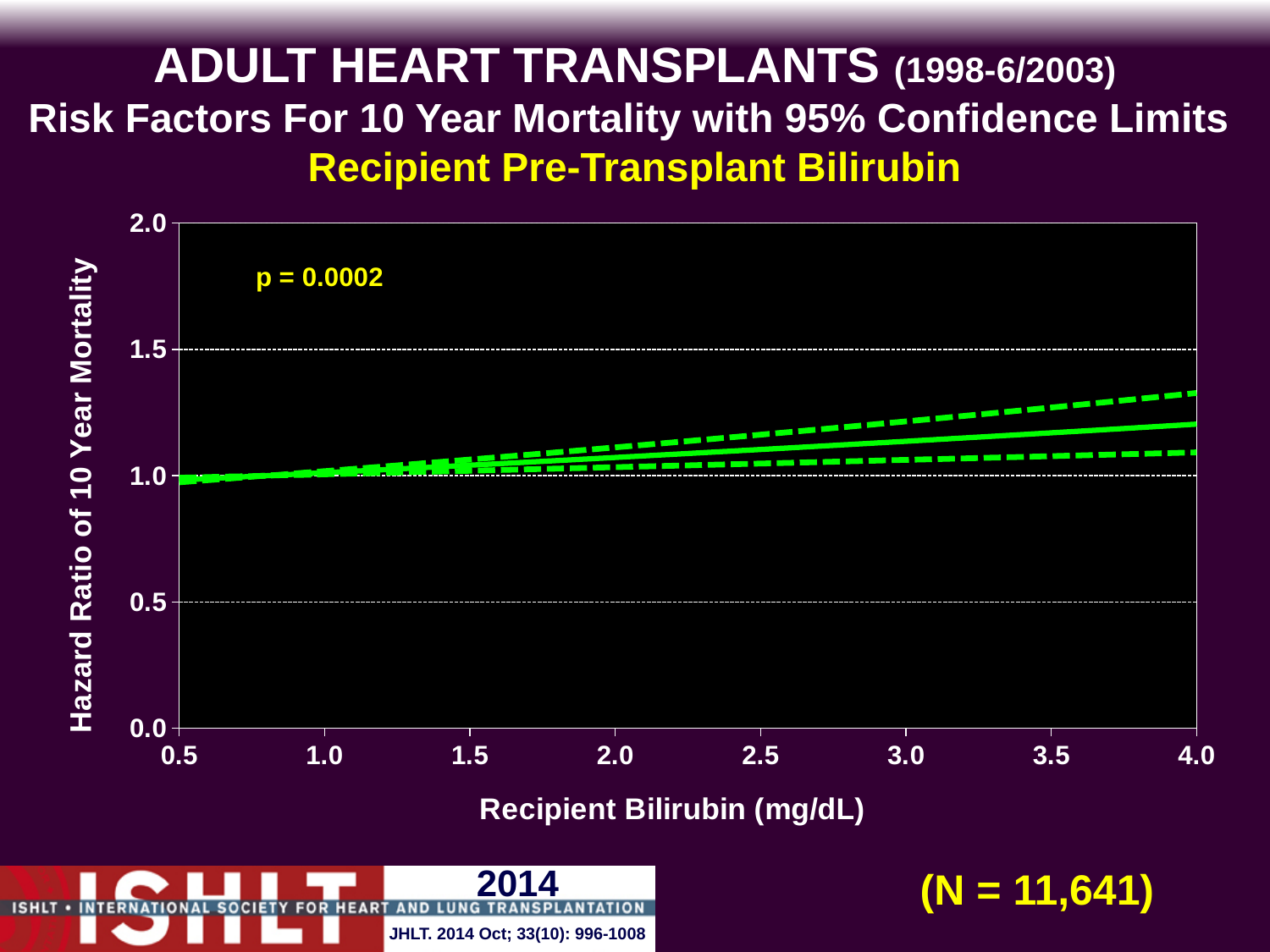
Is the hazard ratio at a recipient bilirubin of 2.0 mg/dL greater or less than 0.5? greater Is the hazard ratio at a recipient bilirubin of 4.0 mg/dL greater or less than 1.5? less Does the hazard ratio of 10 year mortality rise or fall as recipient bilirubin increases from 0.5 to 4.0 mg/dL? rise Is the upper 95% confidence limit at a recipient bilirubin of 4.0 mg/dL greater or less than 1.5? less How many lines are plotted on the chart? 3 What p value is printed on the chart? p = 0.0002 Which recipient bilirubin value has the higher hazard ratio, 1.0 mg/dL or 4.0 mg/dL? 4.0 mg/dL How many tick marks are labelled on the x axis? 8 What kind of chart is shown on the slide? line chart What is the highest value labelled on the y axis? 2.0 What is the label of the x axis? Recipient Bilirubin (mg/dL)